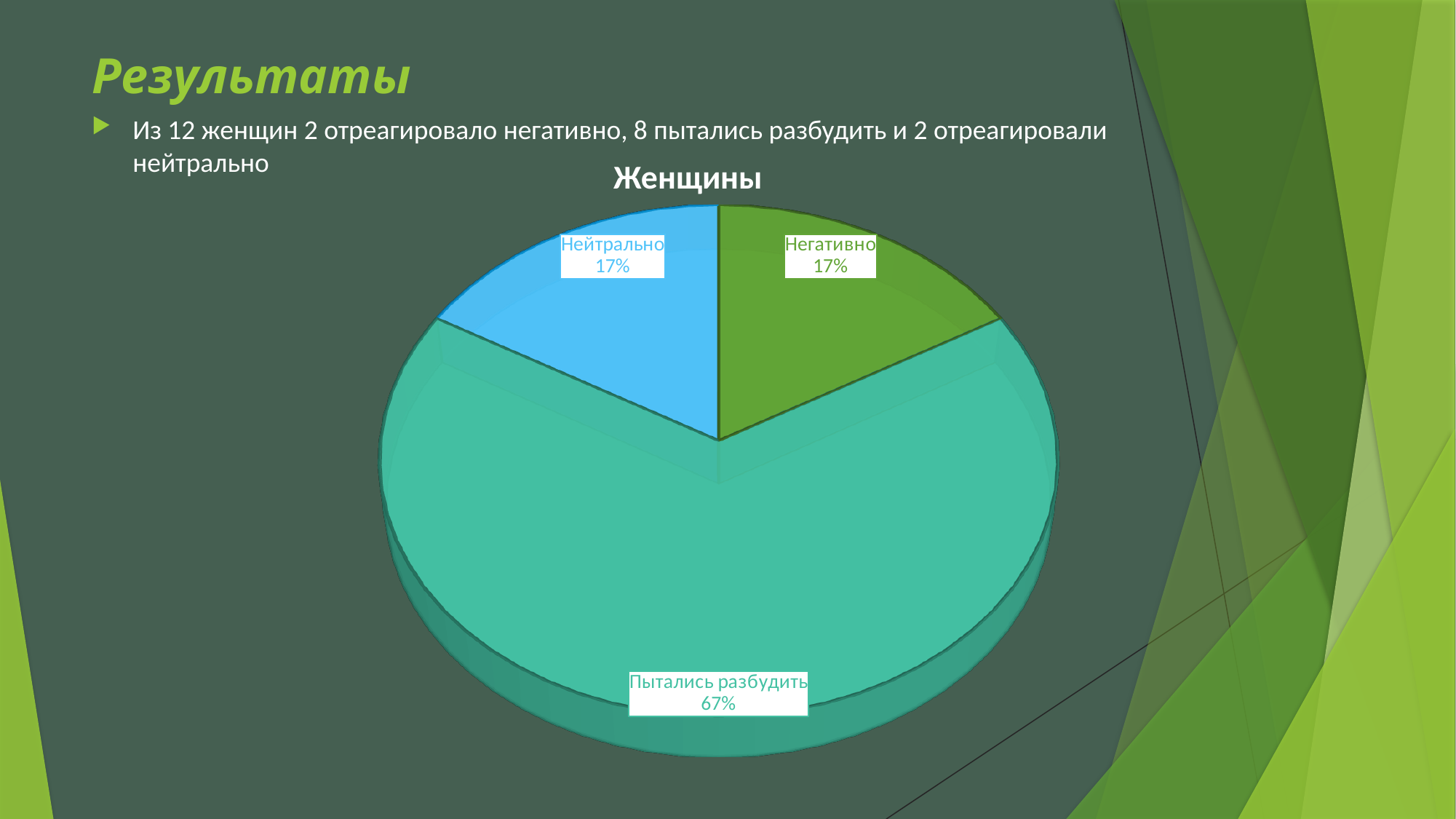
What is the difference in percentage points between the 'Пытались разбудить' slice and the 'Нейтрально' slice? 50 What share of the pie does the slice 'Нейтрально' represent? 17% How many slices does the pie chart have? 3 What colour is the 'Нейтрально' slice? light blue What share of the pie does the slice 'Пытались разбудить' represent? 67% What is the title of the chart? Женщины Which is larger, the slice for 'Пытались разбудить' or the slice for 'Негативно'? Пытались разбудить What kind of chart is shown on the slide? pie chart Which slice of the pie is the largest? Пытались разбудить What share of the pie does the slice 'Негативно' represent? 17%